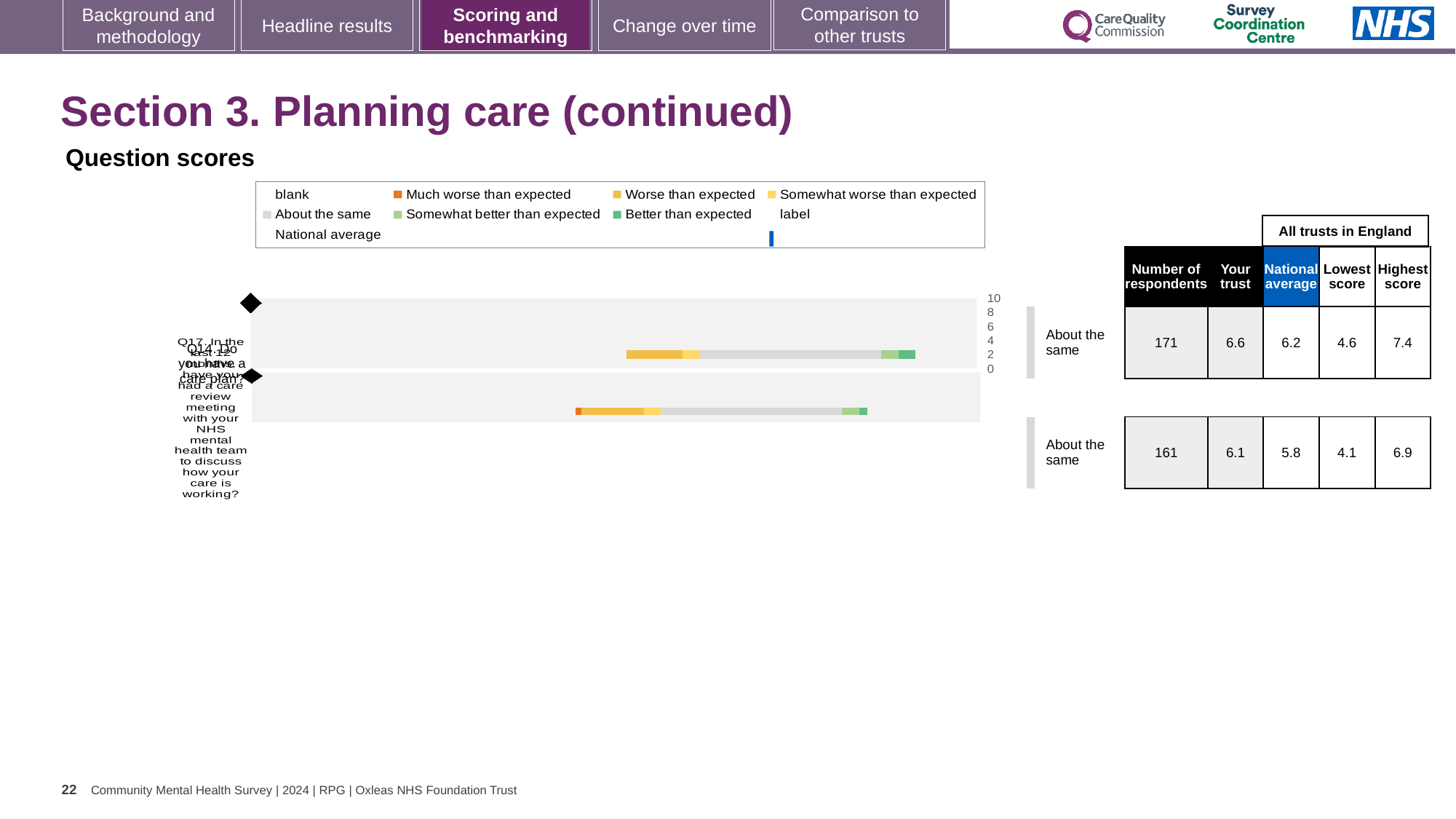
What benchmark category is shown beside both bars in the chart? About the same What is the highest score among all trusts in England for the second row (Q17, bottom bar)? 6.9 What is the national average for the second row (Q17, bottom bar)? 5.8 By how much does the trust's score for the first row (Q14) exceed the national average? 0.4 What is the lowest score among all trusts in England for the first row (Q14, top bar)? 4.6 What kind of chart is shown on the slide? bar chart In the table next to the chart, what is the number of respondents for the first row (Q14, top bar)? 171 Which row has more respondents, the first (Q14) or the second (Q17)? Q14 How many questions (bars) are plotted in the chart? 2 What is the 'Your trust' score for the first row (Q14, top bar)? 6.6 What is the difference between the highest and lowest scores for the second row (Q17)? 2.8 Which row has the higher 'Your trust' score, the first (Q14) or the second (Q17)? Q14